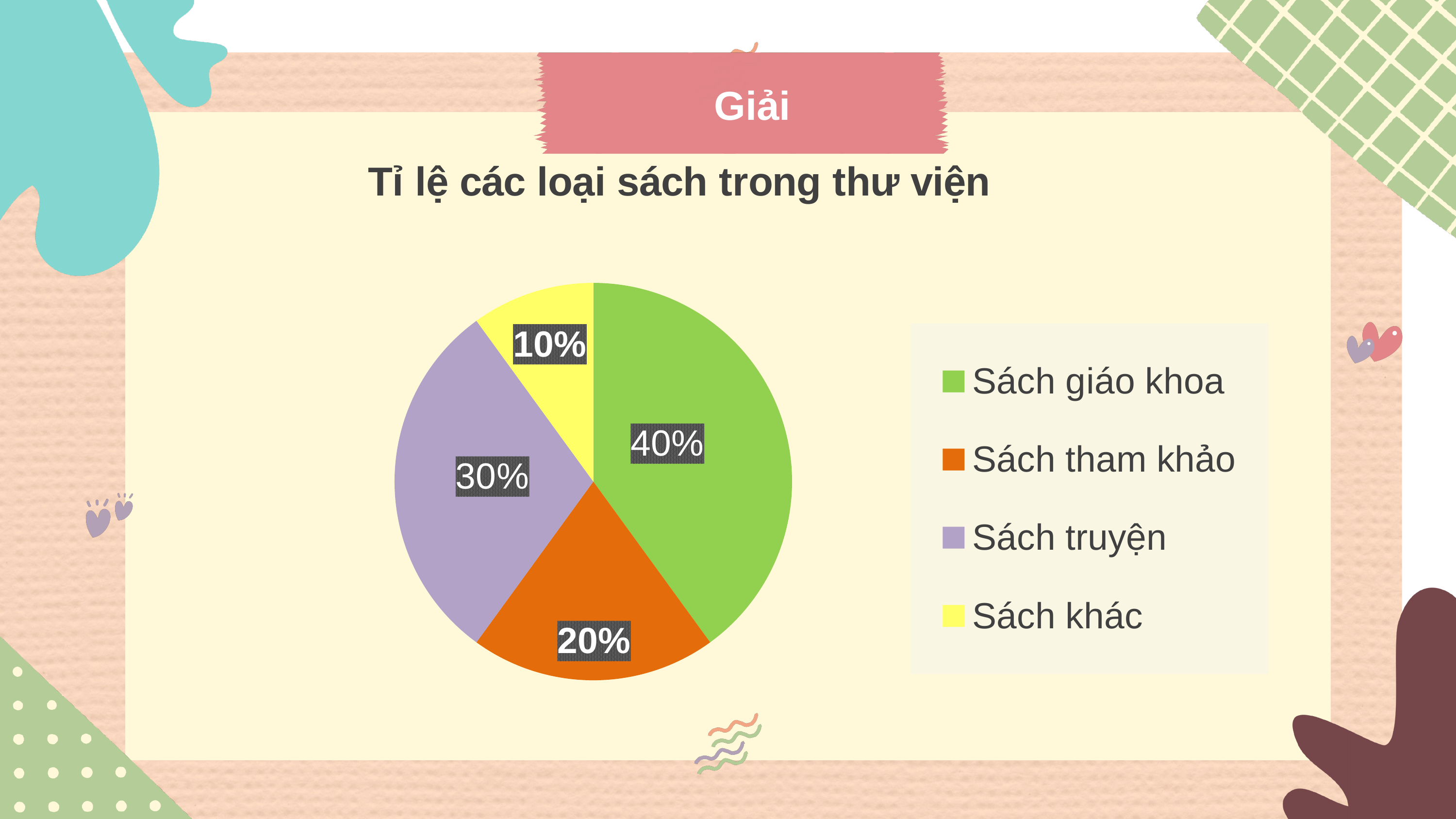
What share of the pie does Sách giáo khoa have? 40% Which category has the smallest slice of the pie? Sách khác What is the title of the chart? Tỉ lệ các loại sách trong thư viện What share of the pie does Sách khác have? 10% What colour is the slice for Sách truyện? Purple What kind of chart is shown on the slide? Pie chart What share of the pie does Sách tham khảo have? 20% Which is larger, the share of Sách tham khảo or the share of Sách truyện? Sách truyện Which category has the largest slice of the pie? Sách giáo khoa What is the difference between the shares of Sách giáo khoa and Sách truyện? 10% How many categories are shown in the pie chart? 4 What share of the pie does Sách truyện have? 30%